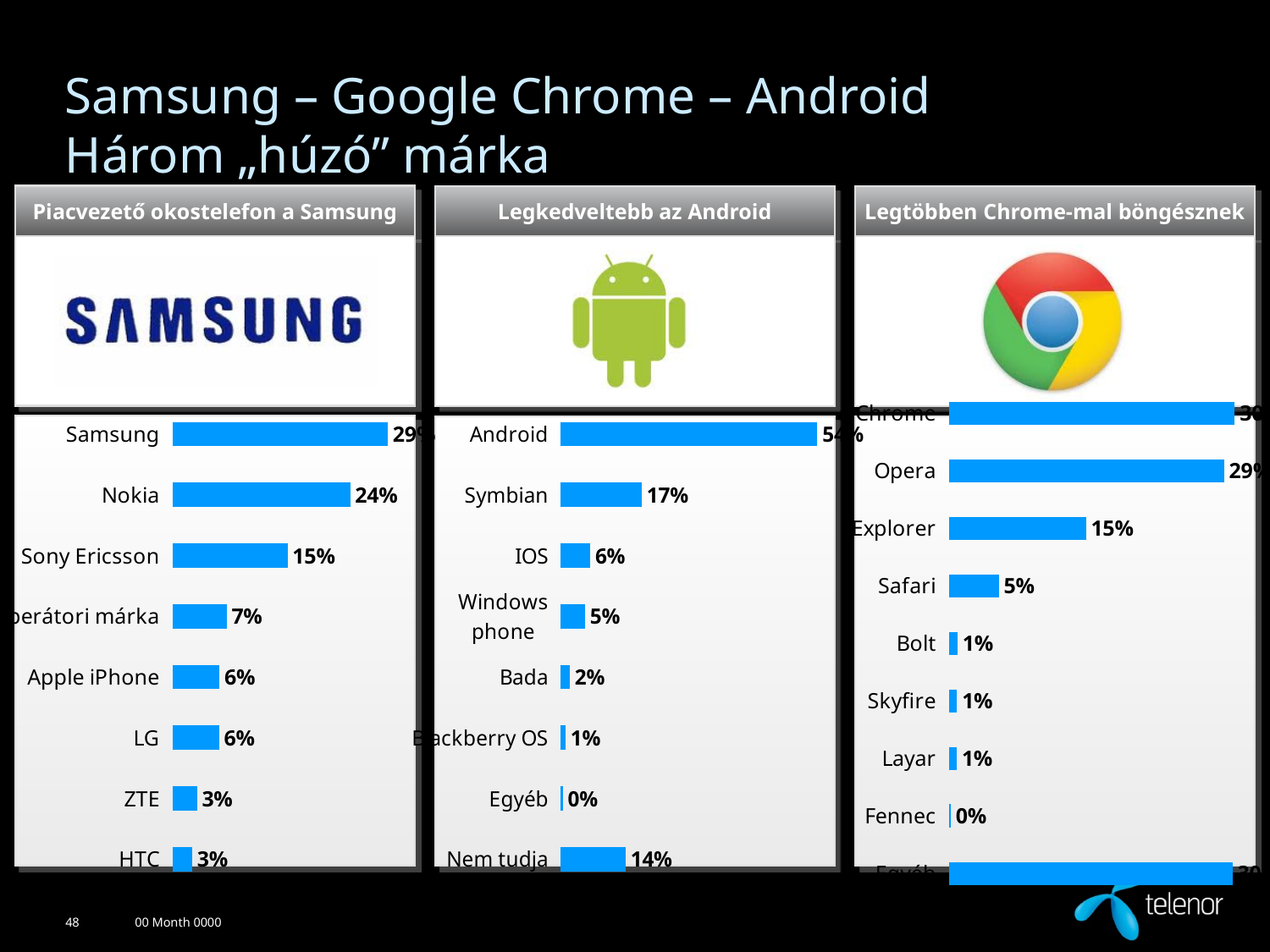
In the chart titled "Legtöbben Chrome-mal böngésznek", what is the difference between the values for Explorer and Safari? 10% In the chart titled "Legtöbben Chrome-mal böngésznek", what is the value for Explorer? 15% In the chart titled "Legkedveltebb az Android", what is the value for Symbian? 17% In the chart titled "Legkedveltebb az Android", which category has the lowest value? Egyéb In the chart titled "Piacvezető okostelefon a Samsung", what is the value for Nokia? 24% What kind of chart is the one titled "Legkedveltebb az Android"? Bar chart In the chart titled "Piacvezető okostelefon a Samsung", how many categories are shown? 8 In the chart titled "Piacvezető okostelefon a Samsung", which has the larger value, Apple iPhone or ZTE? Apple iPhone In the chart titled "Piacvezető okostelefon a Samsung", what is the difference between the values for Nokia and Sony Ericsson? 9% In the chart titled "Legkedveltebb az Android", which category has the highest value? Android In the chart titled "Legkedveltebb az Android", what is the value for Nem tudja? 14% In the chart titled "Piacvezető okostelefon a Samsung", what is the value for Sony Ericsson? 15%